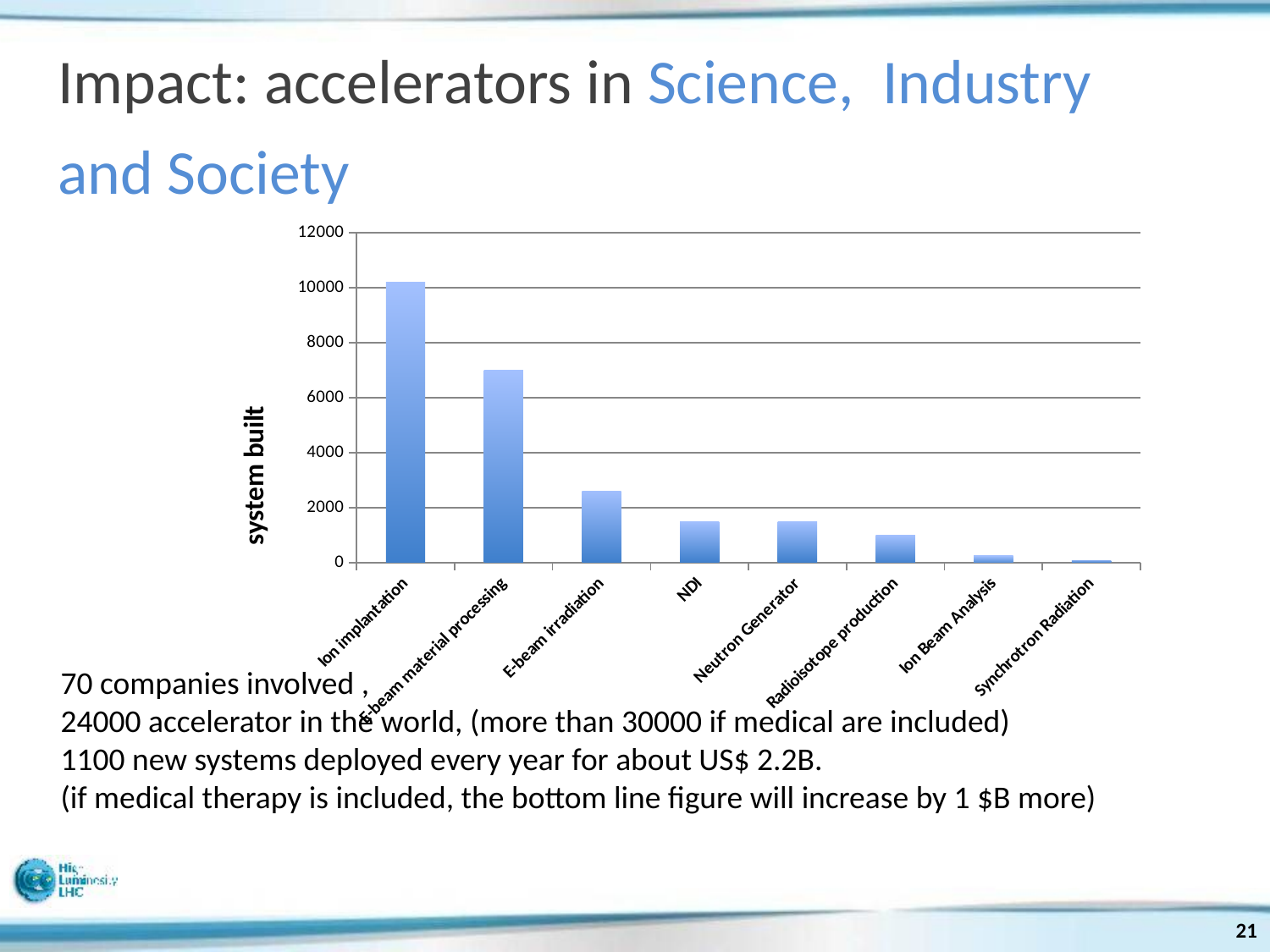
What is the label on the vertical axis of the chart? system built Is the value for E-beam irradiation greater or less than 2000? greater How many categories are plotted along the x axis of the chart? 8 Is the value for Radioisotope production greater or less than 2000? less Which category has the lowest number of systems built? Synchrotron Radiation Which category has the highest number of systems built? Ion implantation Do the bar values generally rise or fall from left to right along the x axis? fall Is the value for E-beam material processing greater or less than 8000? less Which has more systems built, Radioisotope production or Ion Beam Analysis? Radioisotope production What kind of chart is shown on the slide? bar chart Which has more systems built, E-beam irradiation or Neutron Generator? E-beam irradiation